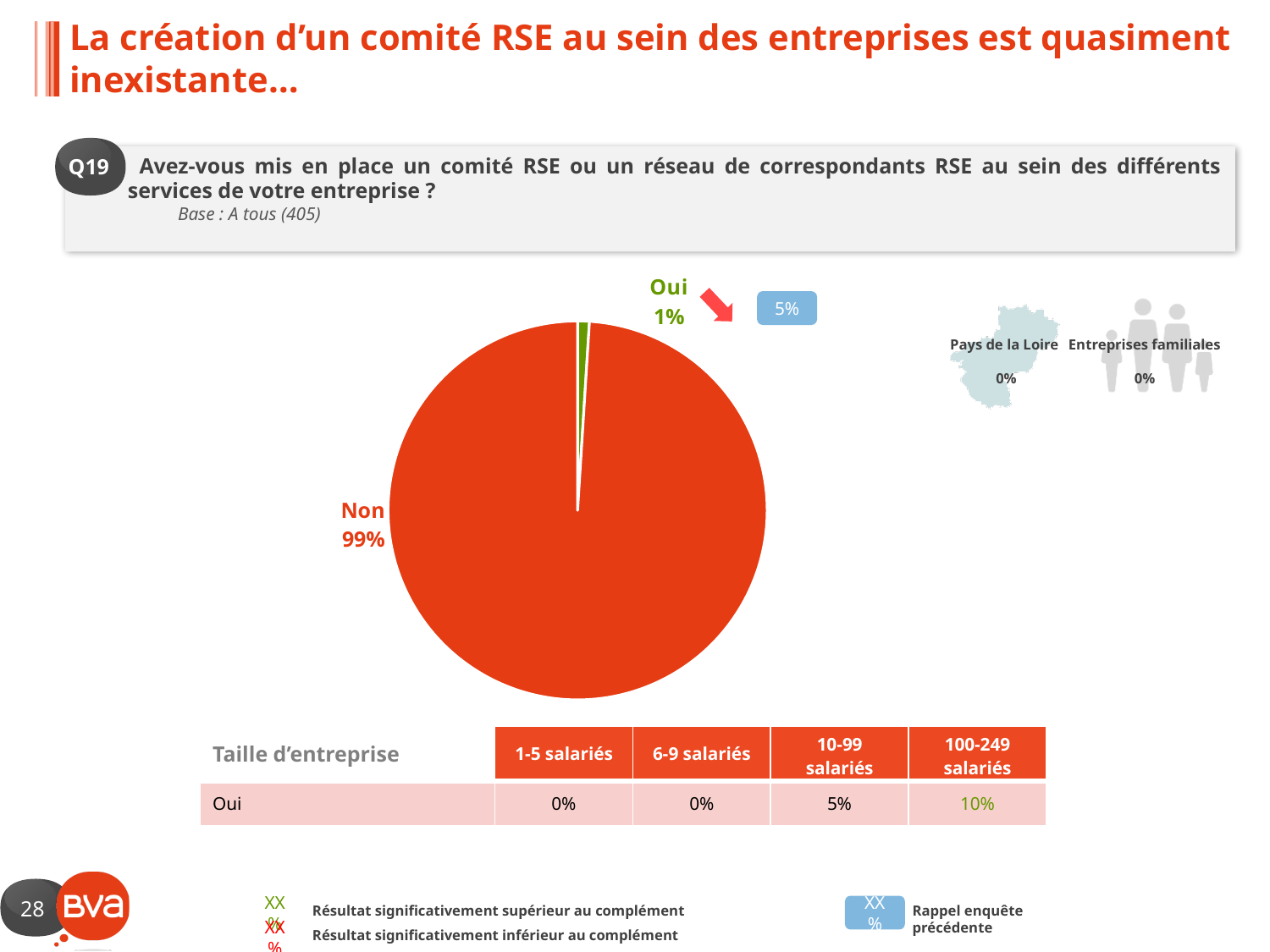
What share of the pie does the "Non" slice represent? 99% Which slice of the pie chart is the largest? Non What kind of chart is shown on the slide? Pie chart What value from the previous survey is shown in the blue box next to the "Oui" slice? 5% What colour is the "Non" slice of the pie chart? Red-orange Which slice of the pie chart is the smallest? Oui What is the difference in percentage points between the "Non" slice and the "Oui" slice? 98 percentage points Which is larger in the pie chart, "Oui" or "Non"? Non What percentage of the pie chart is labelled "Non"? 99% What percentage of the pie chart is labelled "Oui"? 1% How many slices does the pie chart have? 2